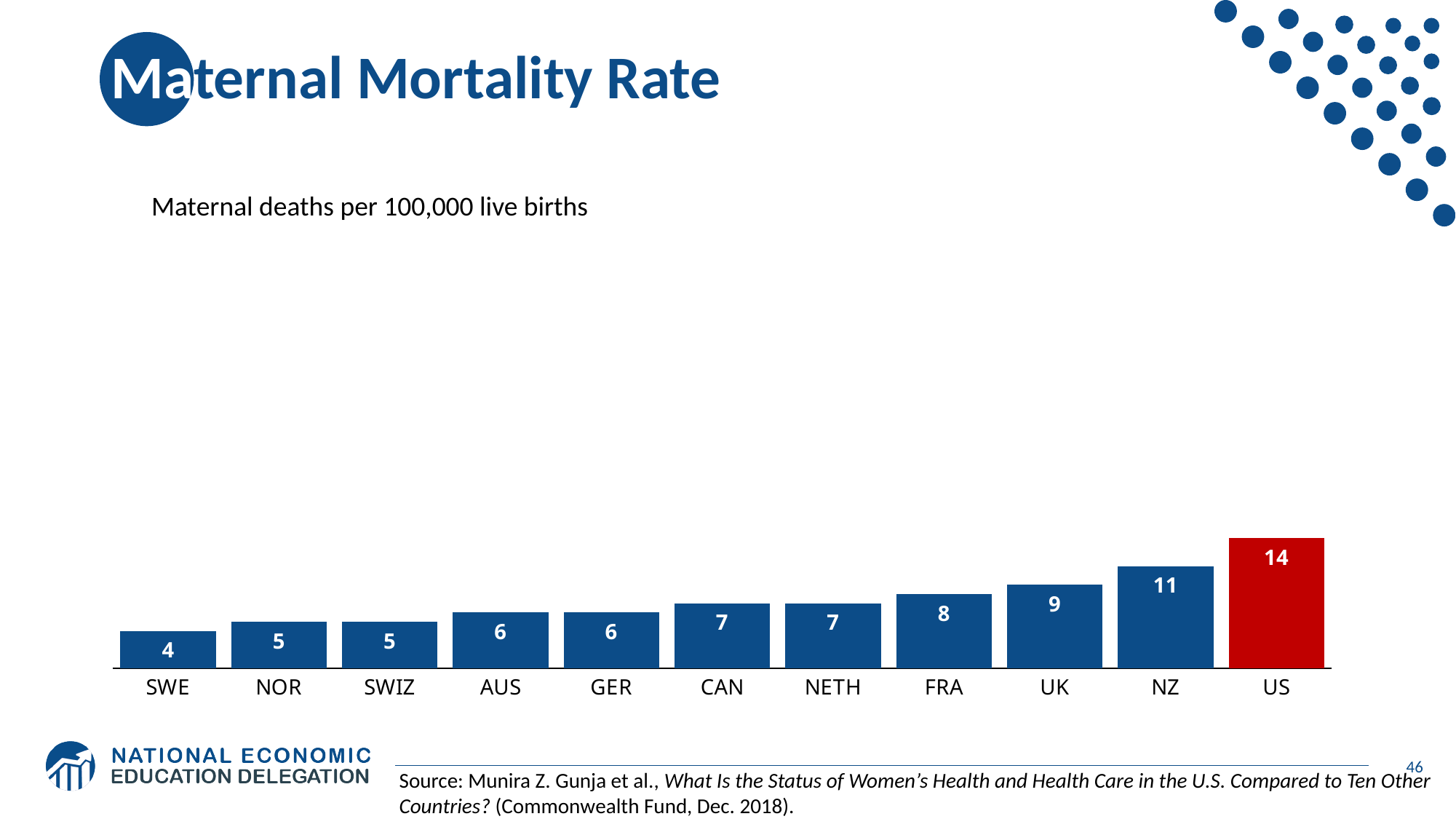
What value is shown for SWE? 4 How many countries are shown on the chart? 11 What is the difference between the values for US and SWE? 10 What value is shown for UK? 9 Which bar is coloured red rather than blue? US Which country has the highest maternal mortality rate on the chart? US What is the difference between the values for US and NZ? 3 What is the maternal mortality rate shown for the US? 14 Which country has the lowest maternal mortality rate on the chart? SWE What type of chart is shown on the slide? bar chart Do the values rise or fall moving from left to right along the x axis? rise Which has a higher value, FRA or CAN? FRA